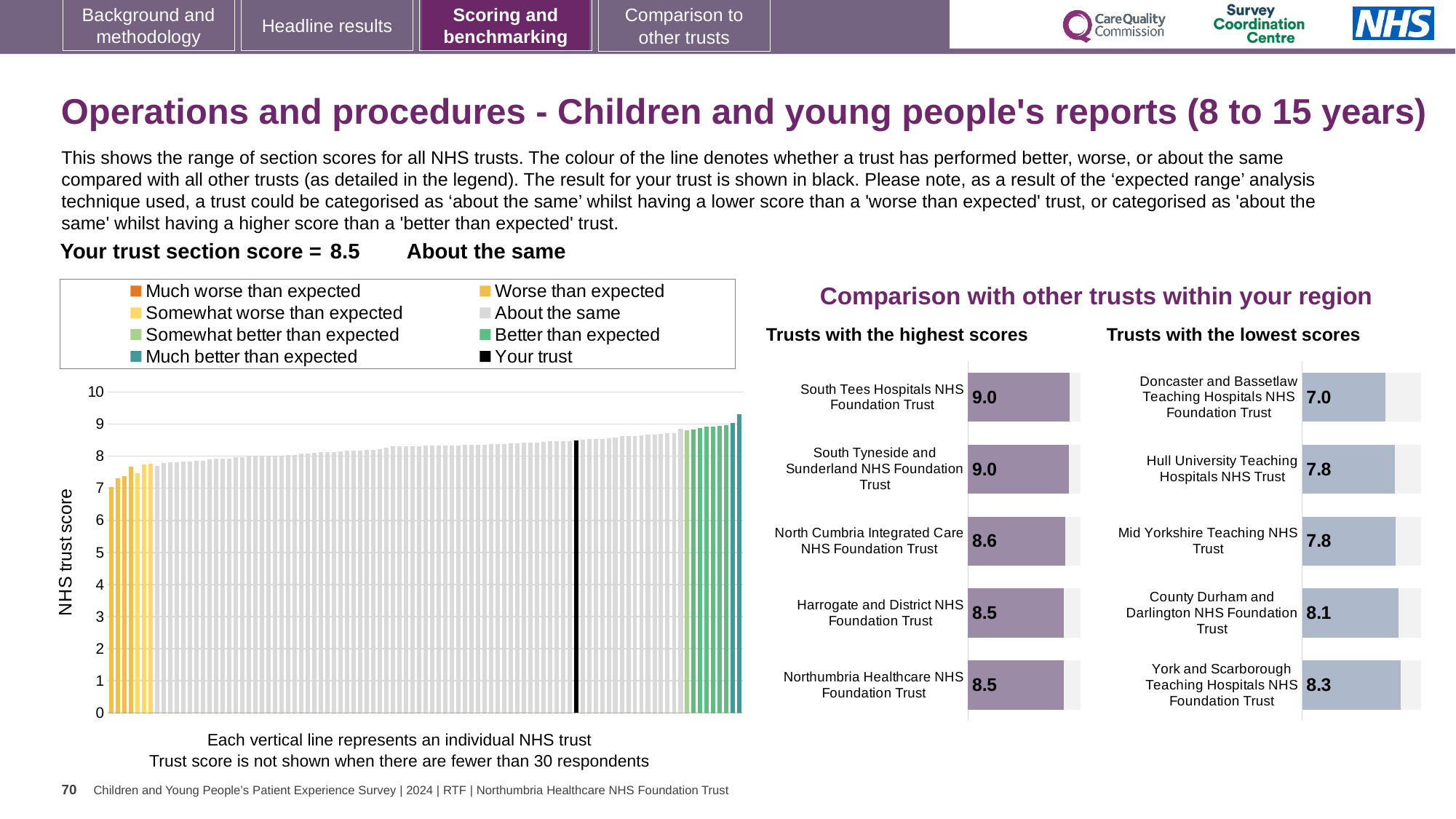
In the main 'NHS trust score' chart, what is the section score for your trust (the black bar)? 8.5 In the main 'NHS trust score' chart, do the values rise or fall from left to right? rise In the 'Trusts with the highest scores' chart, what is the difference between the scores of South Tees Hospitals NHS Foundation Trust and Northumbria Healthcare NHS Foundation Trust? 0.5 In the 'Trusts with the highest scores' chart, what is the score for North Cumbria Integrated Care NHS Foundation Trust? 8.6 In the 'Trusts with the lowest scores' chart, what is the difference between the scores of York and Scarborough Teaching Hospitals NHS Foundation Trust and Doncaster and Bassetlaw Teaching Hospitals NHS Foundation Trust? 1.3 How many trusts are shown in the 'Trusts with the highest scores' chart? 5 In the 'Trusts with the lowest scores' chart, which has the higher score: County Durham and Darlington NHS Foundation Trust or York and Scarborough Teaching Hospitals NHS Foundation Trust? York and Scarborough Teaching Hospitals NHS Foundation Trust In the 'Trusts with the lowest scores' chart, what is the score for Doncaster and Bassetlaw Teaching Hospitals NHS Foundation Trust? 7.0 What kind of chart is the main 'NHS trust score' chart on the left? bar chart What is the label on the vertical axis of the main chart on the left? NHS trust score How many entries does the legend of the main 'NHS trust score' chart list? 8 In the 'Trusts with the lowest scores' chart, which trust has the lowest score? Doncaster and Bassetlaw Teaching Hospitals NHS Foundation Trust